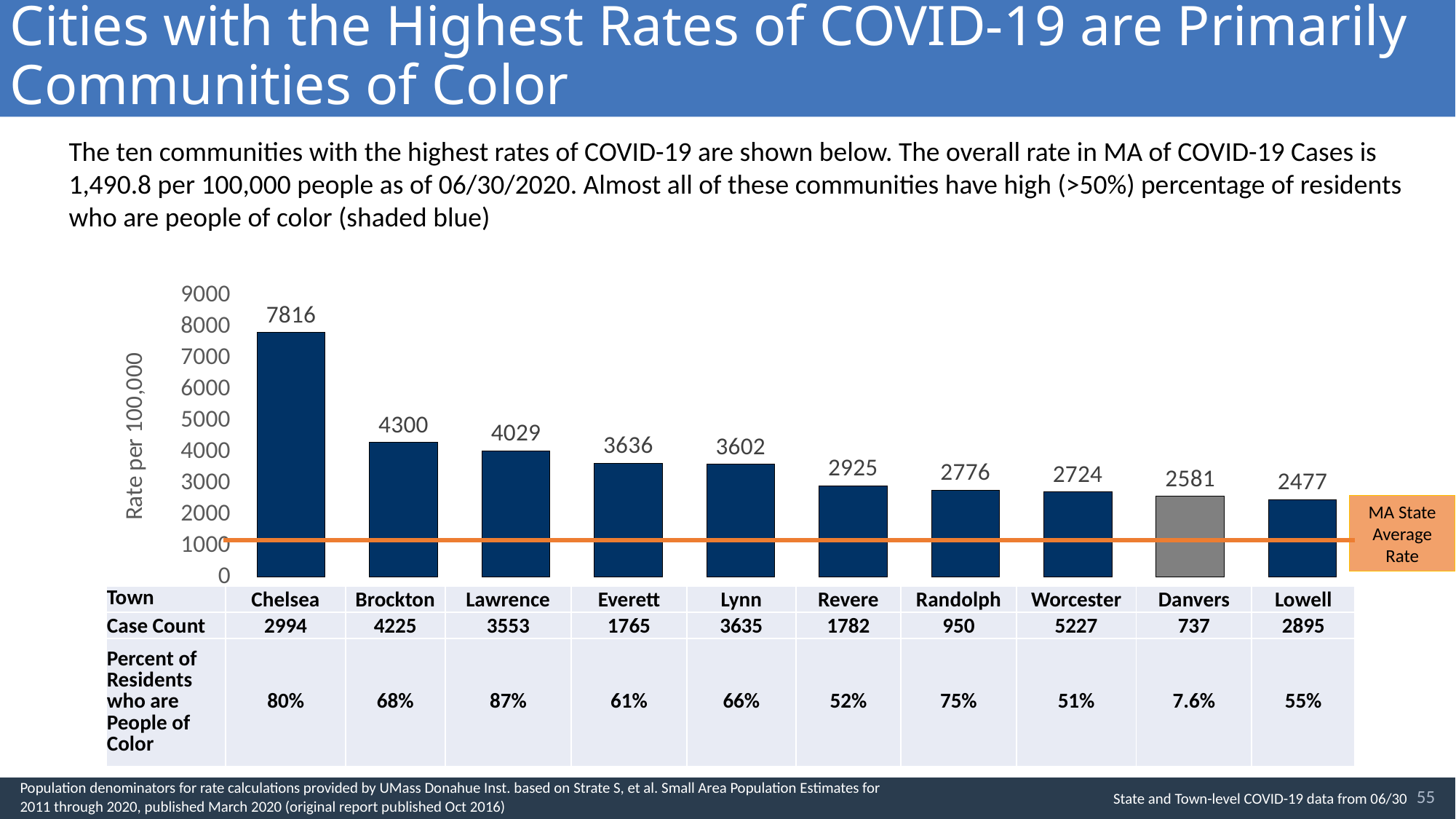
What is the rate per 100,000 for Danvers? 2581 What is the rate per 100,000 for Chelsea? 7816 What kind of chart is shown on the slide? bar chart What is the difference between the rates for Brockton and Lawrence? 271 What is the rate per 100,000 for Lawrence? 4029 Which town has the lowest rate per 100,000 among those shown? Lowell How many towns are shown in the chart? 10 Is the rate for Worcester greater or less than 3000? less Which town has the highest rate per 100,000? Chelsea Do the bar values rise or fall from left to right across the towns? fall What does the orange horizontal line on the chart represent? MA State Average Rate Which has a higher rate per 100,000, Everett or Revere? Everett